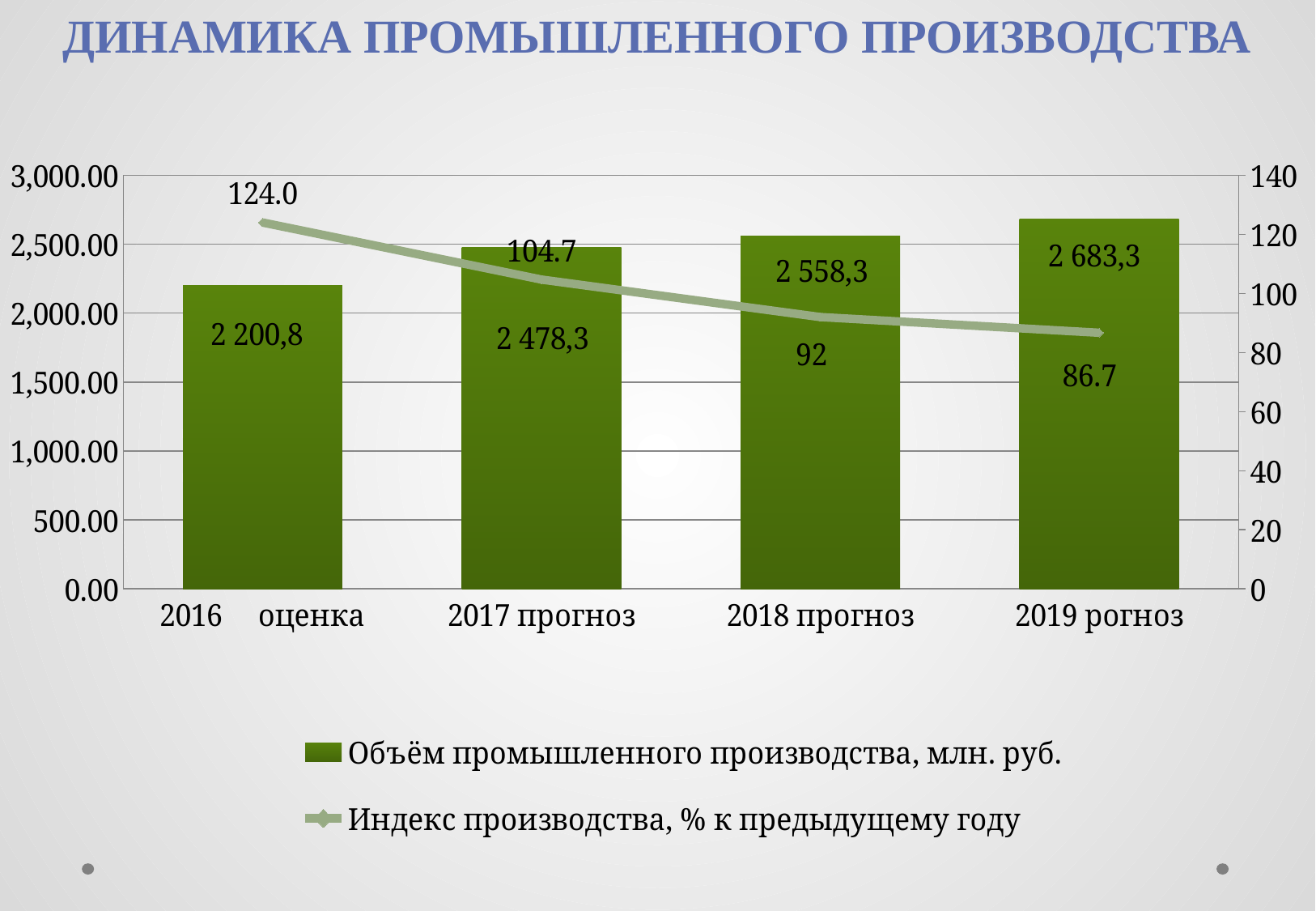
Which year has the lowest Индекс производства? 2019 рогноз What is the value of Объём промышленного производства for 2019 рогноз? 2 683,3 What is the Индекс производства value for 2017 прогноз? 104.7 Which is larger, the Индекс производства for 2016 оценка or for 2018 прогноз? 2016 оценка How many categories are shown on the x axis? 4 How many series does the legend list? 2 What is the value of Объём промышленного производства for 2016 оценка? 2 200,8 Does the Индекс производства line rise or fall from 2016 to 2019? fall Which year has the highest Объём промышленного производства? 2019 рогноз What is the difference in Объём промышленного производства between 2019 рогноз and 2016 оценка? 482,5 What is the title of the chart? ДИНАМИКА ПРОМЫШЛЕННОГО ПРОИЗВОДСТВА What is the Индекс производства value for 2018 прогноз? 92